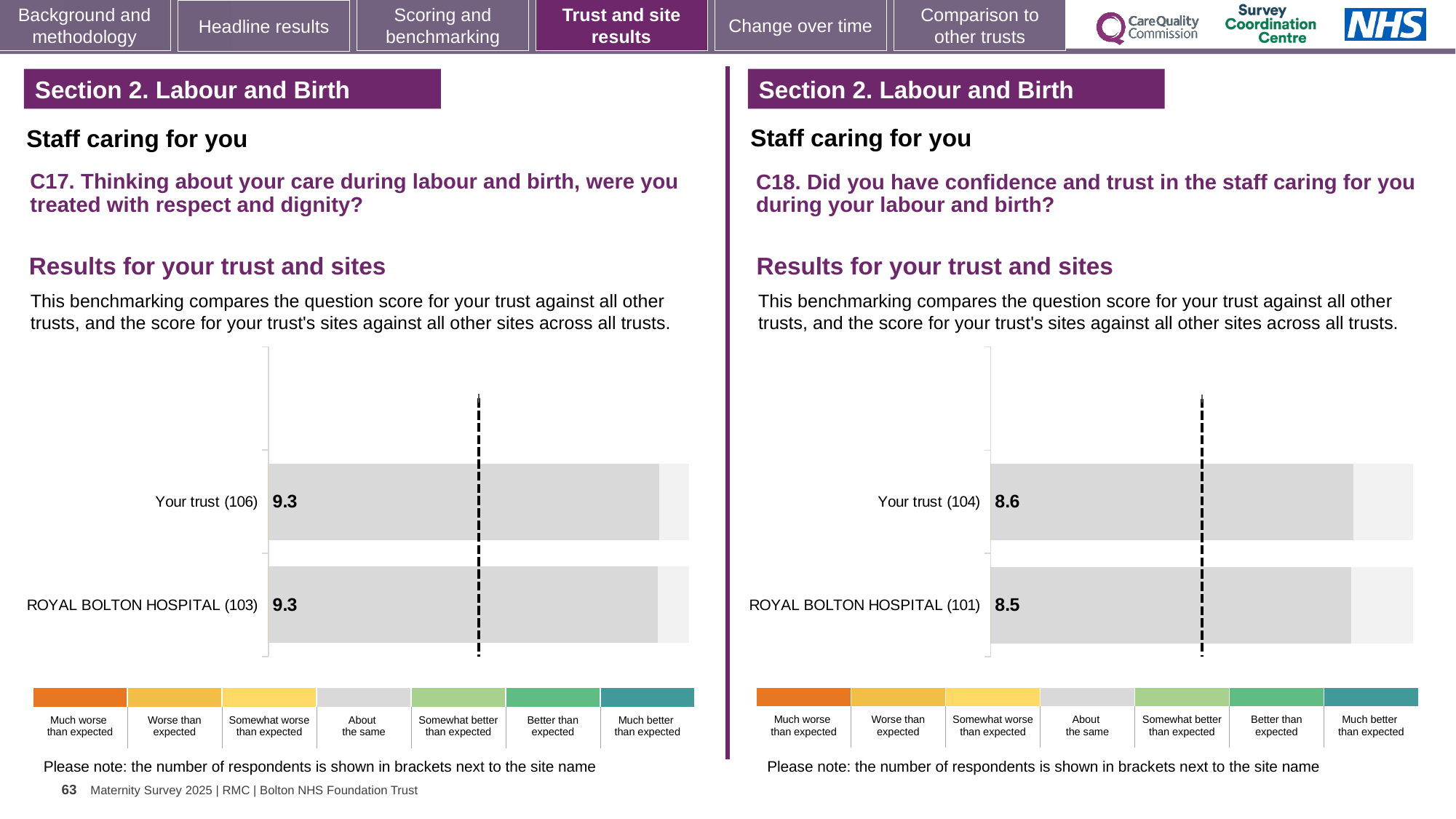
In the C18 chart on the right, what is the score for ROYAL BOLTON HOSPITAL? 8.5 What type of chart is used for the C17 results on the left? Bar chart In the C18 chart on the right, what is the score for Your trust? 8.6 In the C18 chart on the right, what is the difference between the score for Your trust and the score for ROYAL BOLTON HOSPITAL? 0.1 How many bars are plotted in the C18 chart on the right? 2 In the C18 chart on the right, which has the higher score, Your trust or ROYAL BOLTON HOSPITAL? Your trust In the C17 chart on the left, what is the score for Your trust? 9.3 In the C18 chart on the right, how many respondents are shown in brackets for Your trust? 104 How many bars are plotted in the C17 chart on the left? 2 In the C17 chart on the left, is the score for Your trust the same as the score for ROYAL BOLTON HOSPITAL? Yes In the C17 chart on the left, what is the score for ROYAL BOLTON HOSPITAL? 9.3 In the C17 chart on the left, how many respondents are shown in brackets for ROYAL BOLTON HOSPITAL? 103